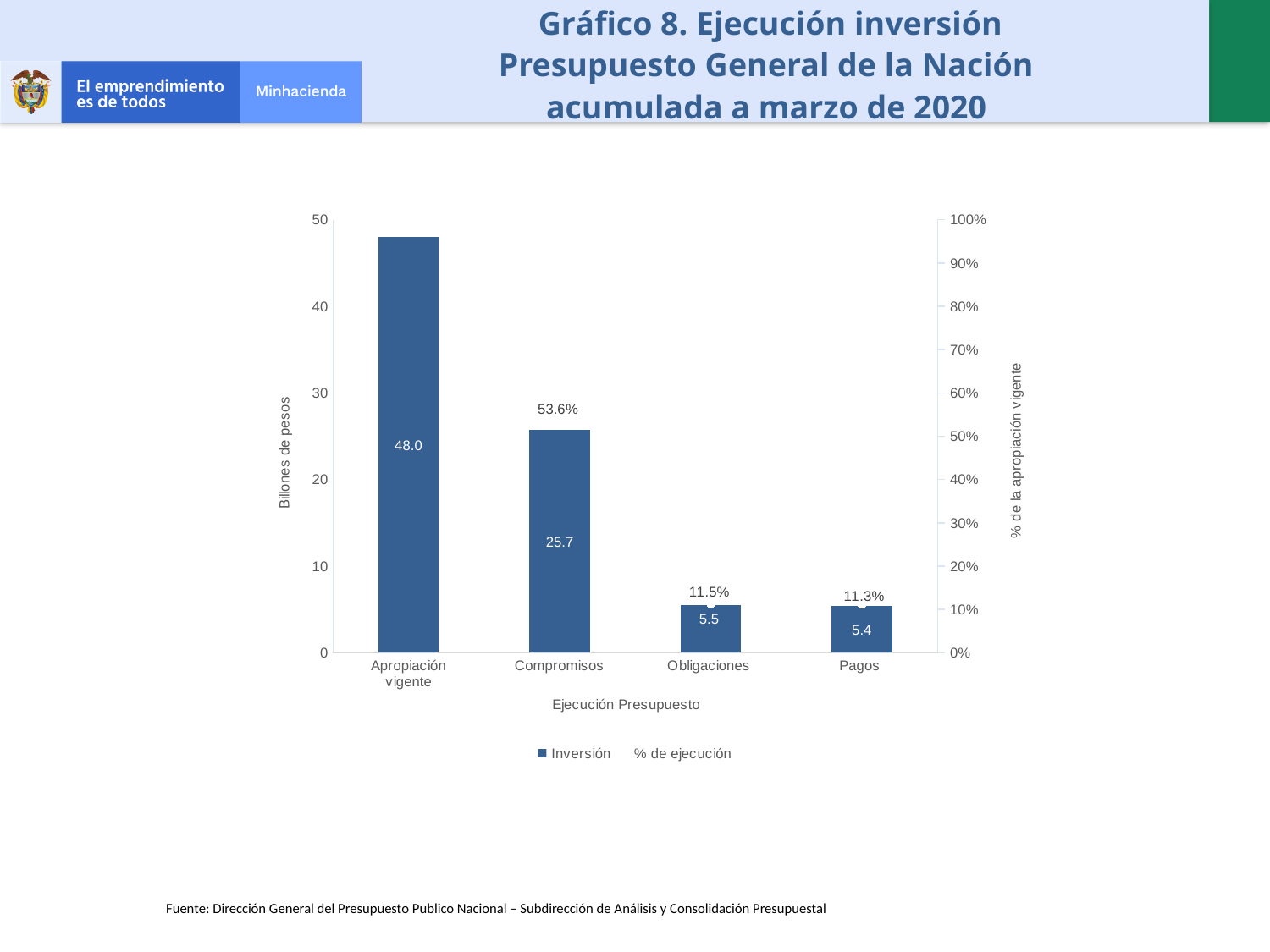
How many categories are shown on the x axis? 4 What is the Inversión value for Apropiación vigente? 48.0 Which category has the lowest Inversión value? Pagos What is the % de ejecución for Obligaciones? 11.5% What is the difference in Inversión between Apropiación vigente and Compromisos? 22.3 What is the % de ejecución for Pagos? 11.3% Which has a larger Inversión value, Compromisos or Obligaciones? Compromisos What kind of chart is shown on the slide? Bar chart What is the Inversión value for Compromisos? 25.7 Which category has the highest Inversión value? Apropiación vigente What is the label of the left vertical axis? Billones de pesos How many series does the legend list? 2